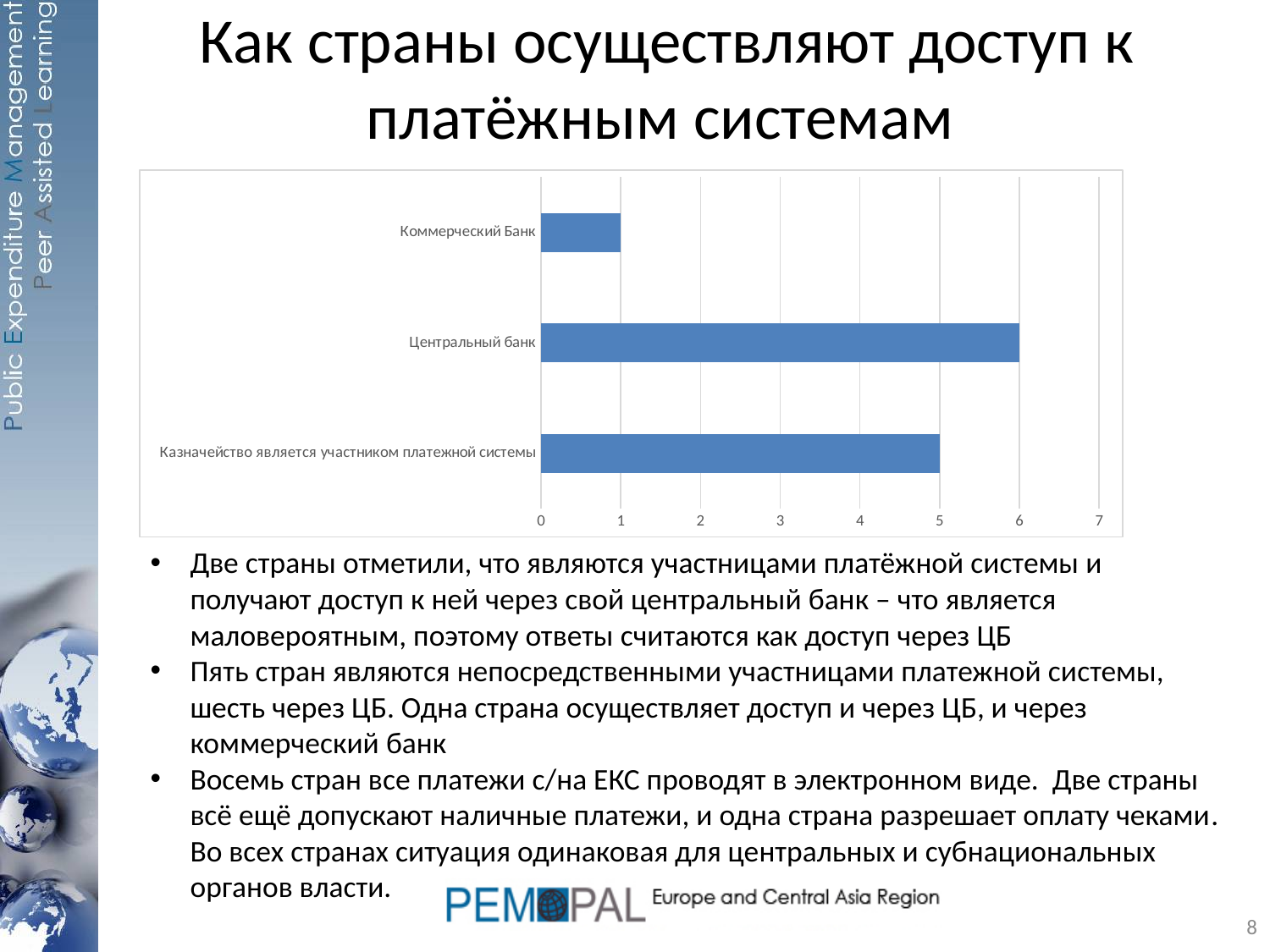
What is the difference between the values for Центральный банк and Коммерческий Банк? 5 What is the difference between the values for Центральный банк and Казначейство является участником платежной системы? 1 Which is larger, the value for Казначейство является участником платежной системы or the value for Коммерческий Банк? Казначейство является участником платежной системы How many categories are shown in the chart? 3 Which category has the lowest value? Коммерческий Банк What is the value for Центральный банк? 6 What is the value for Казначейство является участником платежной системы? 5 What is the value for Коммерческий Банк? 1 What is the maximum value shown on the horizontal axis of the chart? 7 Is the value for Центральный банк greater or less than 4? greater What type of chart is shown on the slide? bar chart Which category has the highest value? Центральный банк